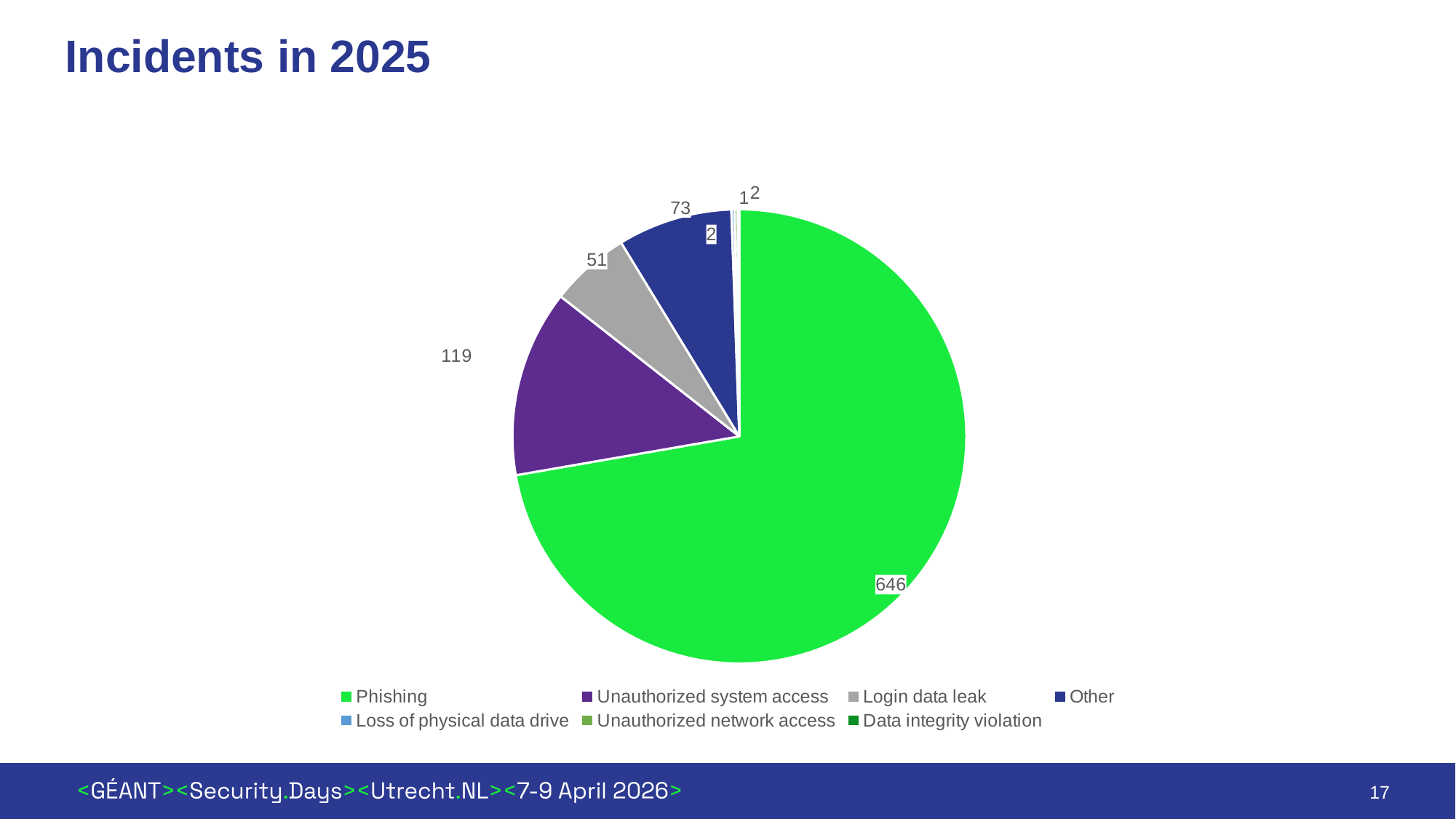
What is the value for Unauthorized system access? 119 How many categories does the legend list? 7 What is the title of the slide? Incidents in 2025 What kind of chart is shown on the slide? Pie chart What is the value for Login data leak? 51 What is the value for the Other category? 73 What is the difference between the Unauthorized system access value and the Other value? 46 How many incidents are shown for Phishing? 646 What is the difference between the Phishing value and the Unauthorized system access value? 527 Which is larger, the Other slice or the Login data leak slice? Other What is the difference between the Other value and the Login data leak value? 22 Which category has the largest slice of the pie? Phishing